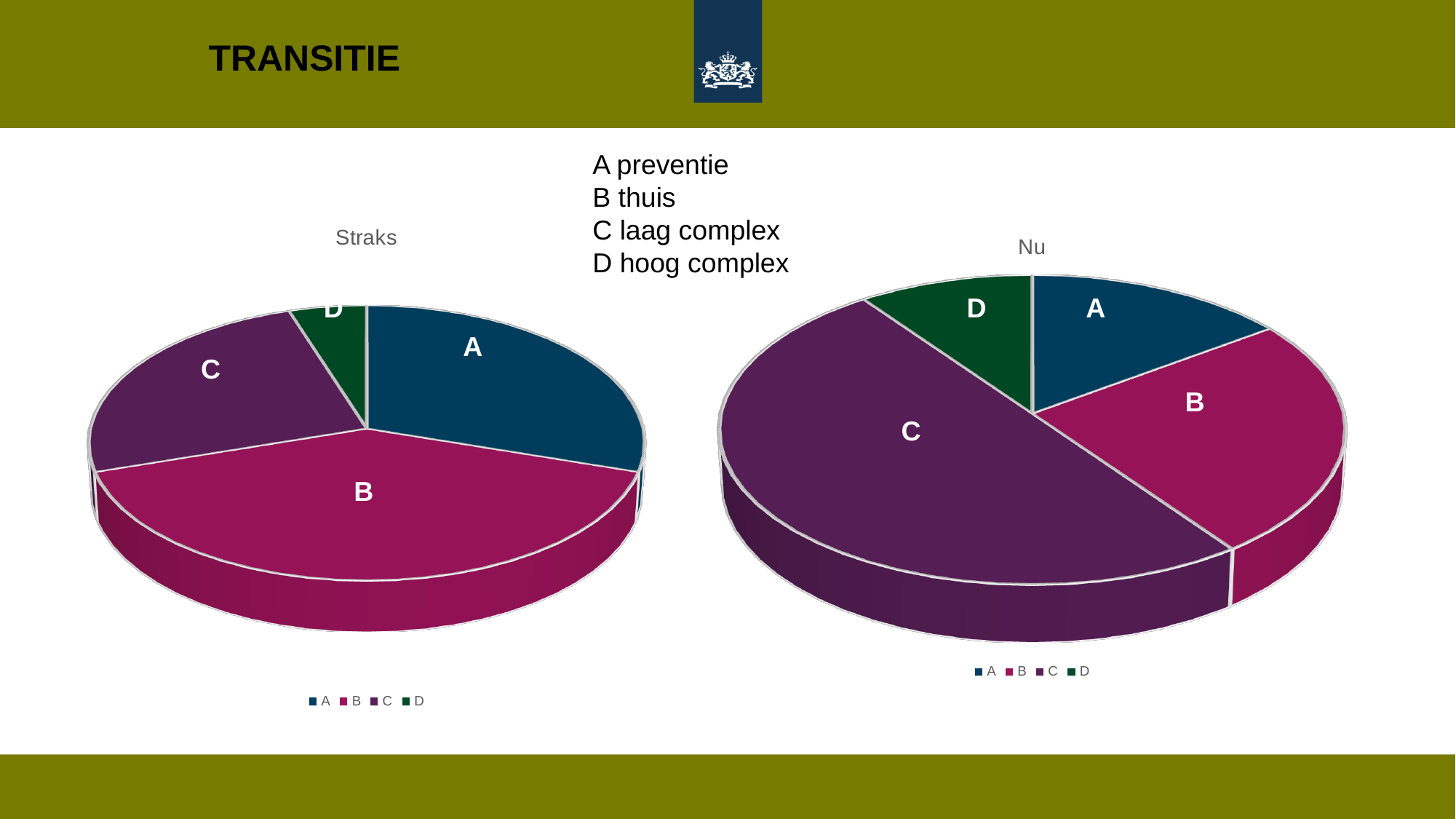
What is the title of the pie chart on the left side of the slide? Straks In the chart titled "Straks", which slice is the largest? B In the chart titled "Nu", how many slices does the pie have? 4 In the chart titled "Straks", which slice is larger, A or D? A In the chart titled "Nu", which slice is larger, B or D? B In the chart titled "Straks", which slice is the smallest? D In the chart titled "Straks", how many slices does the pie have? 4 What kind of chart is the chart titled "Nu"? pie chart In the chart titled "Nu", which slice is the largest? C In the chart titled "Nu", which slice is the smallest? D What kind of chart is the chart titled "Straks"? pie chart How many entries does the legend of the chart titled "Nu" list? 4